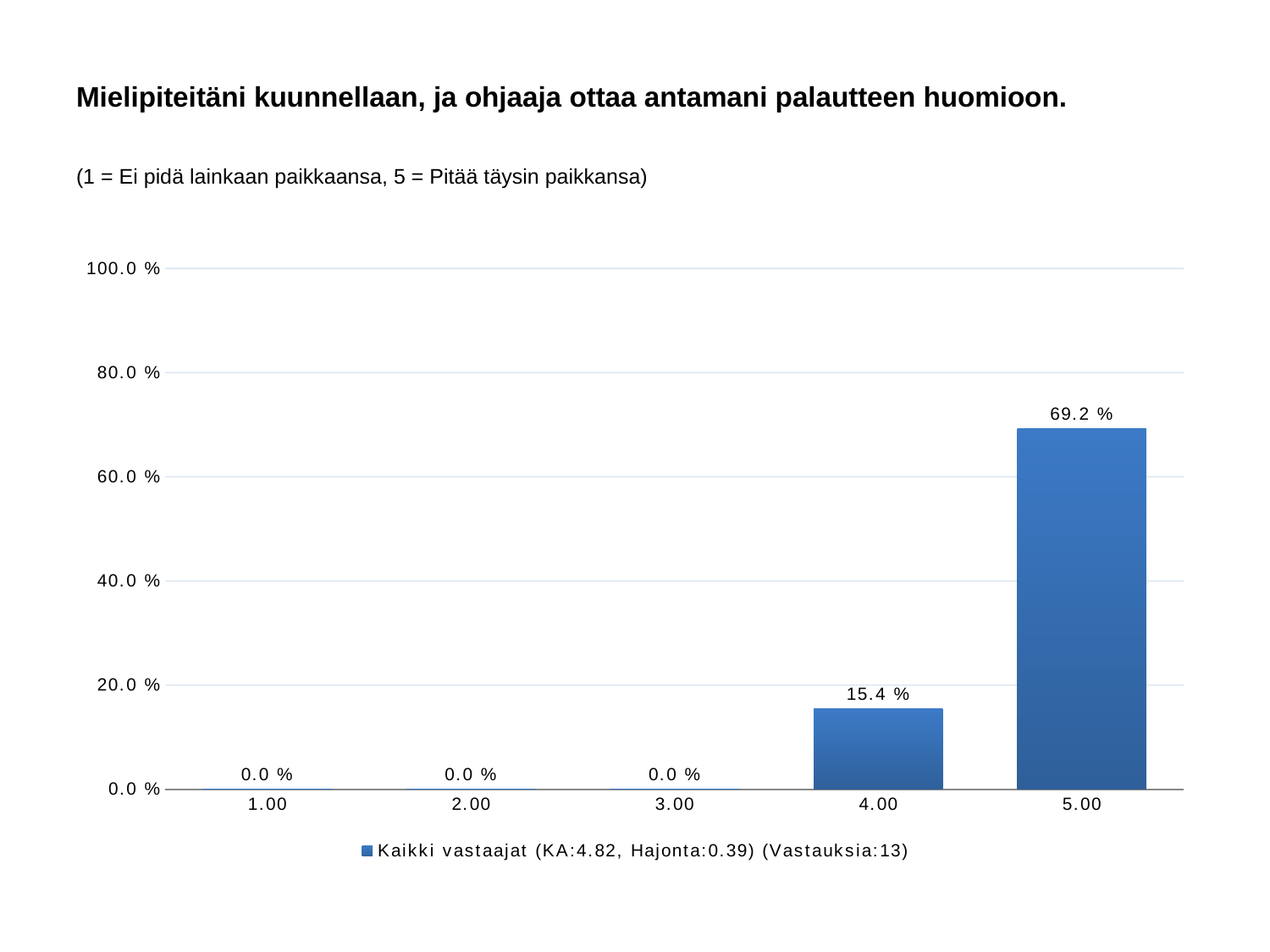
Which category has the highest value? 5.00 What kind of chart is shown? bar chart What is the value for category 4.00? 15.4 % How many series does the legend list? 1 What is the value for category 1.00? 0.0 % How many responses (Vastauksia) does the legend report? 13 Is the value for 5.00 greater or less than 60.0 %? greater How many categories are shown on the x axis? 5 What is the difference between the values for 5.00 and 4.00? 53.8 % What is the value for category 5.00? 69.2 % Is the value for 4.00 greater or less than 20.0 %? less Which is larger, the value for 4.00 or the value for 5.00? 5.00